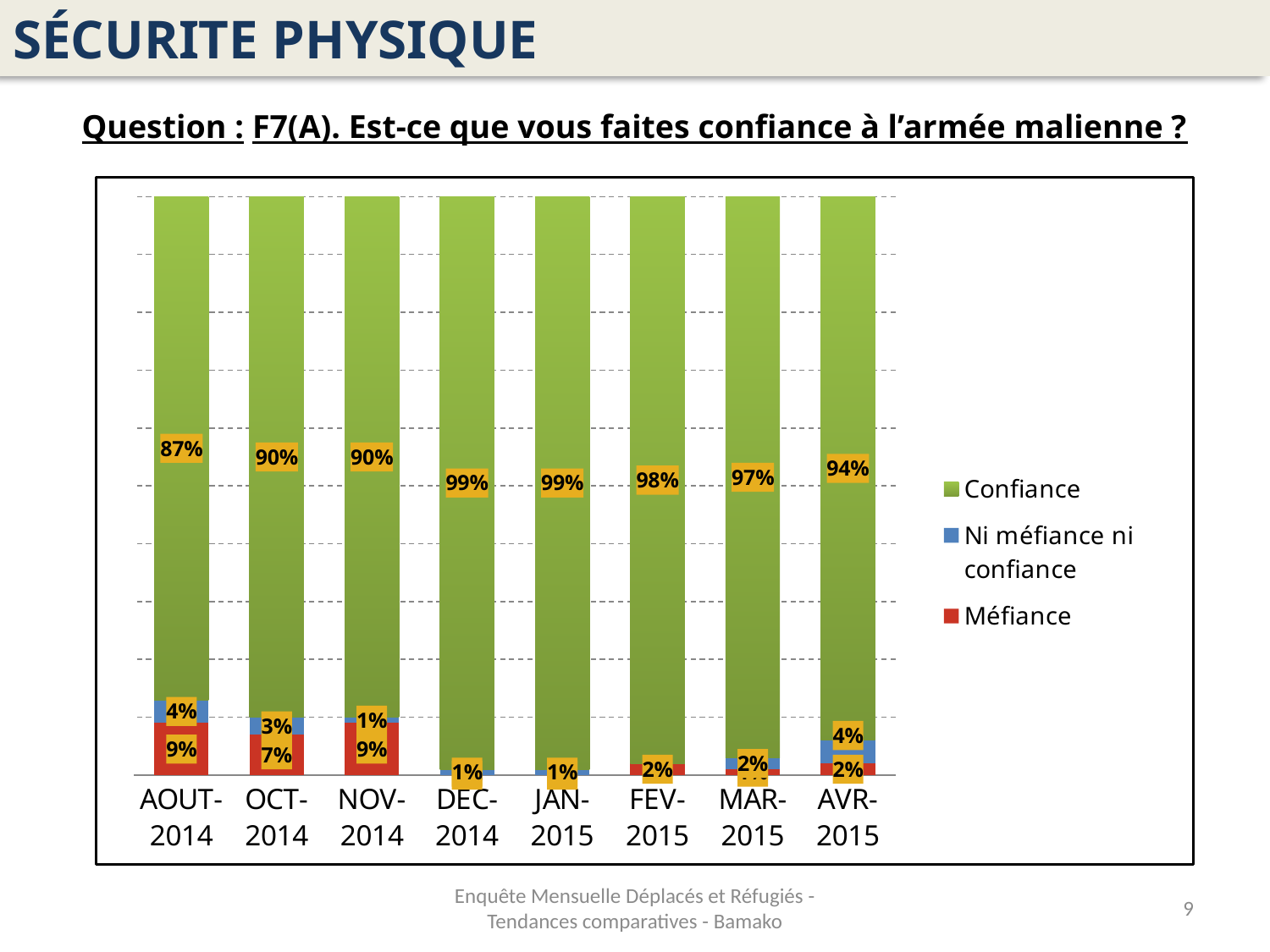
How many series does the legend list? 3 What is the 'Ni méfiance ni confiance' value for AVR-2015? 4% What is the Confiance value for AOUT-2014? 87% How many months (categories) are shown on the x axis? 8 What is the Méfiance value for NOV-2014? 9% Is the Méfiance value larger for OCT-2014 or for FEV-2015? OCT-2014 What is the Confiance value for DEC-2014? 99% What type of chart is shown on the slide? stacked bar chart Which month has the lowest Confiance value? AOUT-2014 What is the difference between the Confiance values for AVR-2015 and AOUT-2014? 7% Which series is shown in green in the legend? Confiance Does the Confiance value rise or fall from AOUT-2014 to DEC-2014? rise